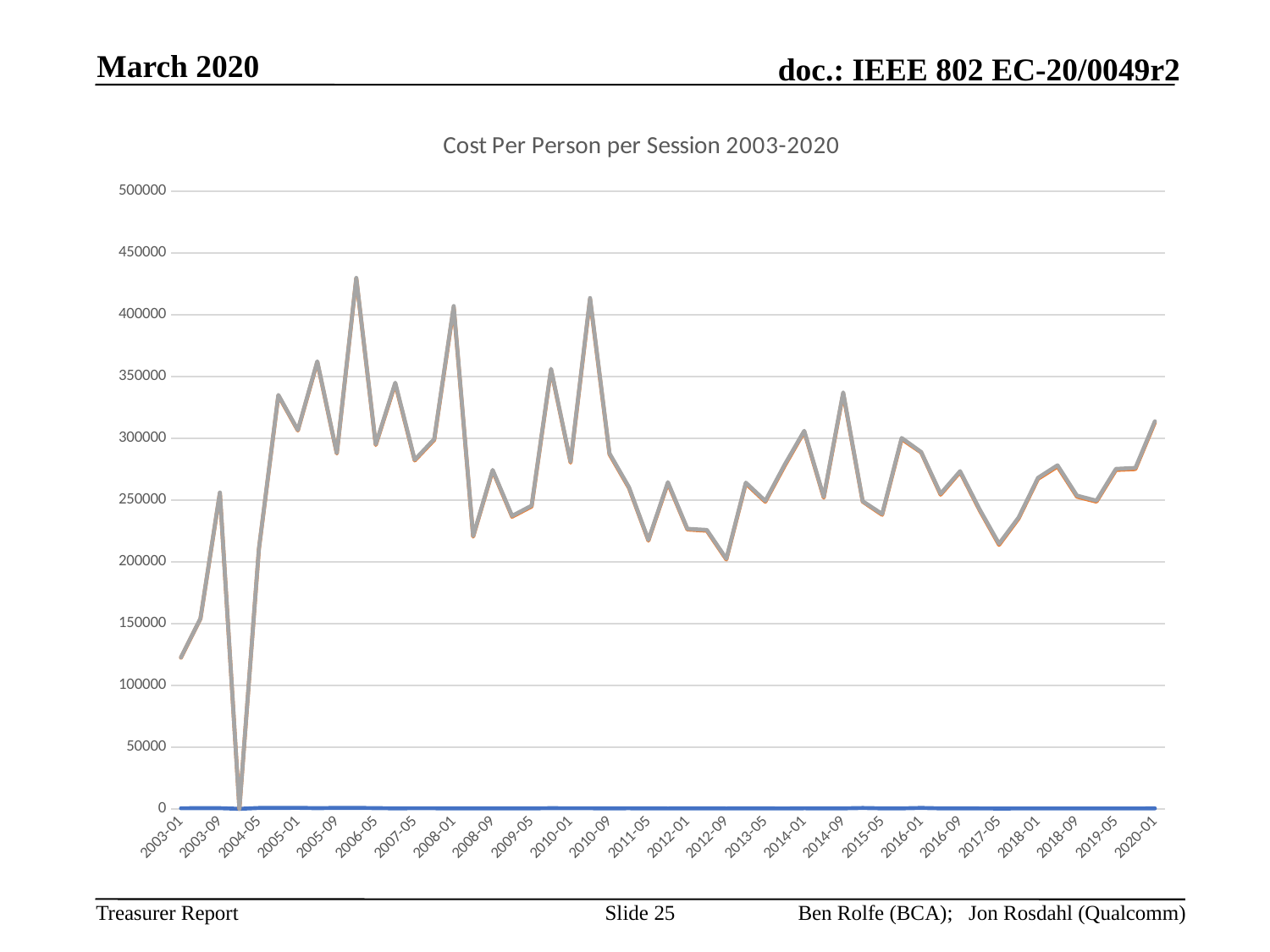
Is the value for 2003-01 greater or less than 150000? less What is the title of the chart? Cost Per Person per Session 2003-2020 Is the value for 2004-05 greater or less than 50000? greater Is the value for 2017-05 greater or less than 250000? less Which has the larger value, 2003-01 or 2020-01? 2020-01 Does the line rise or fall between 2003-01 and 2003-09? rise What is the highest value shown on the vertical axis? 500000 What kind of chart is shown on the slide? line chart